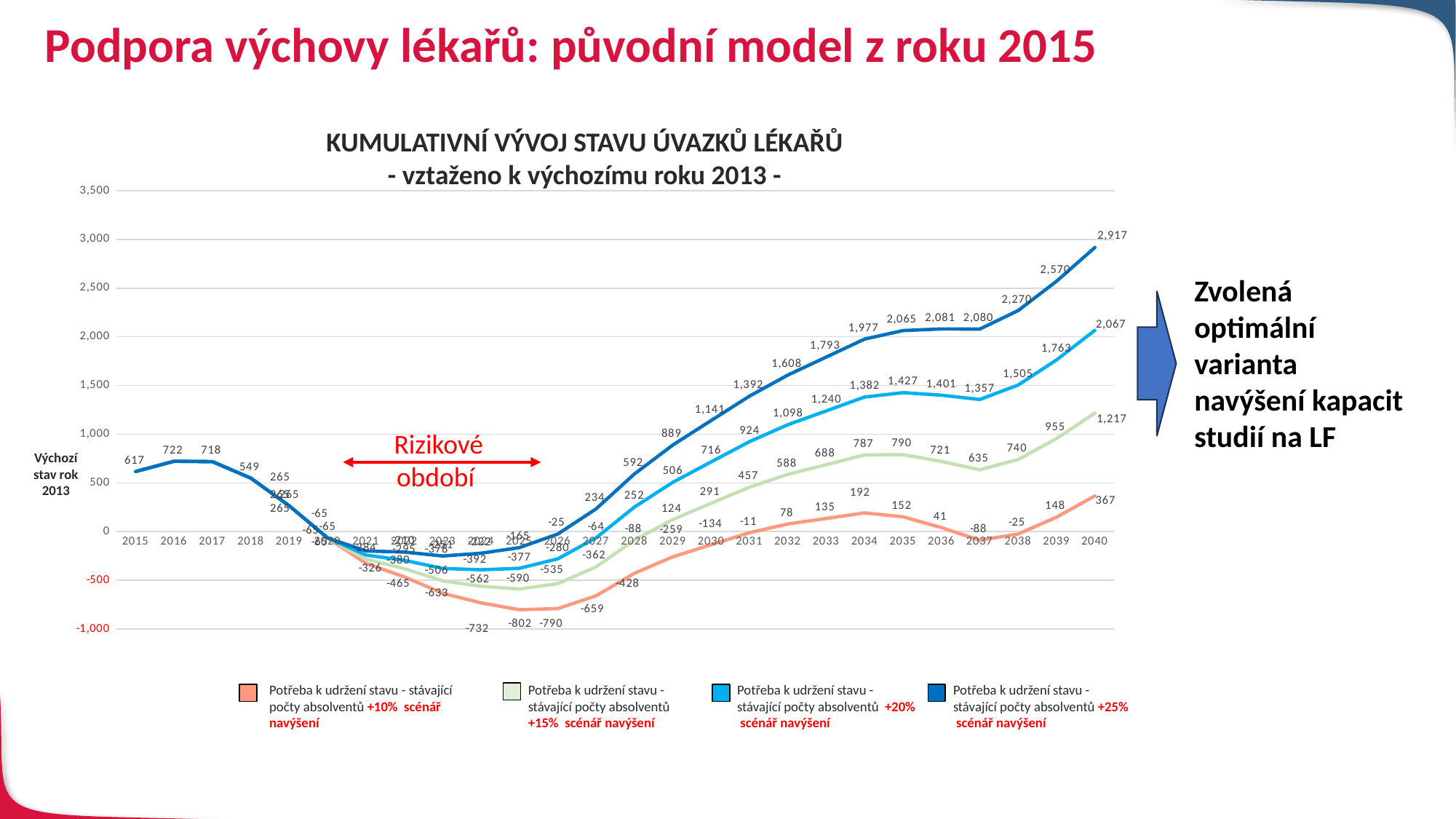
What is the title of the chart? KUMULATIVNÍ VÝVOJ STAVU ÚVAZKŮ LÉKAŘŮ - vztaženo k výchozímu roku 2013 - How many series does the legend list? 4 What is the value of the +10% scénář navýšení series in 2040? 367 How many years are shown on the x axis? 26 What is the value of the +15% scénář navýšení series in 2039? 955 For the +20% scénář navýšení series, which year has the larger value, 2035 or 2036? 2035 What is the value shown for 2016? 722 In which year does the +25% scénář navýšení series reach its highest value? 2040 What is the value of the +25% scénář navýšení series in 2040? 2,917 What is the difference between the +25% and +20% scénář navýšení series in 2040? 850 What is the lowest value of the +10% scénář navýšení series? -802 What kind of chart is shown on the slide? line chart